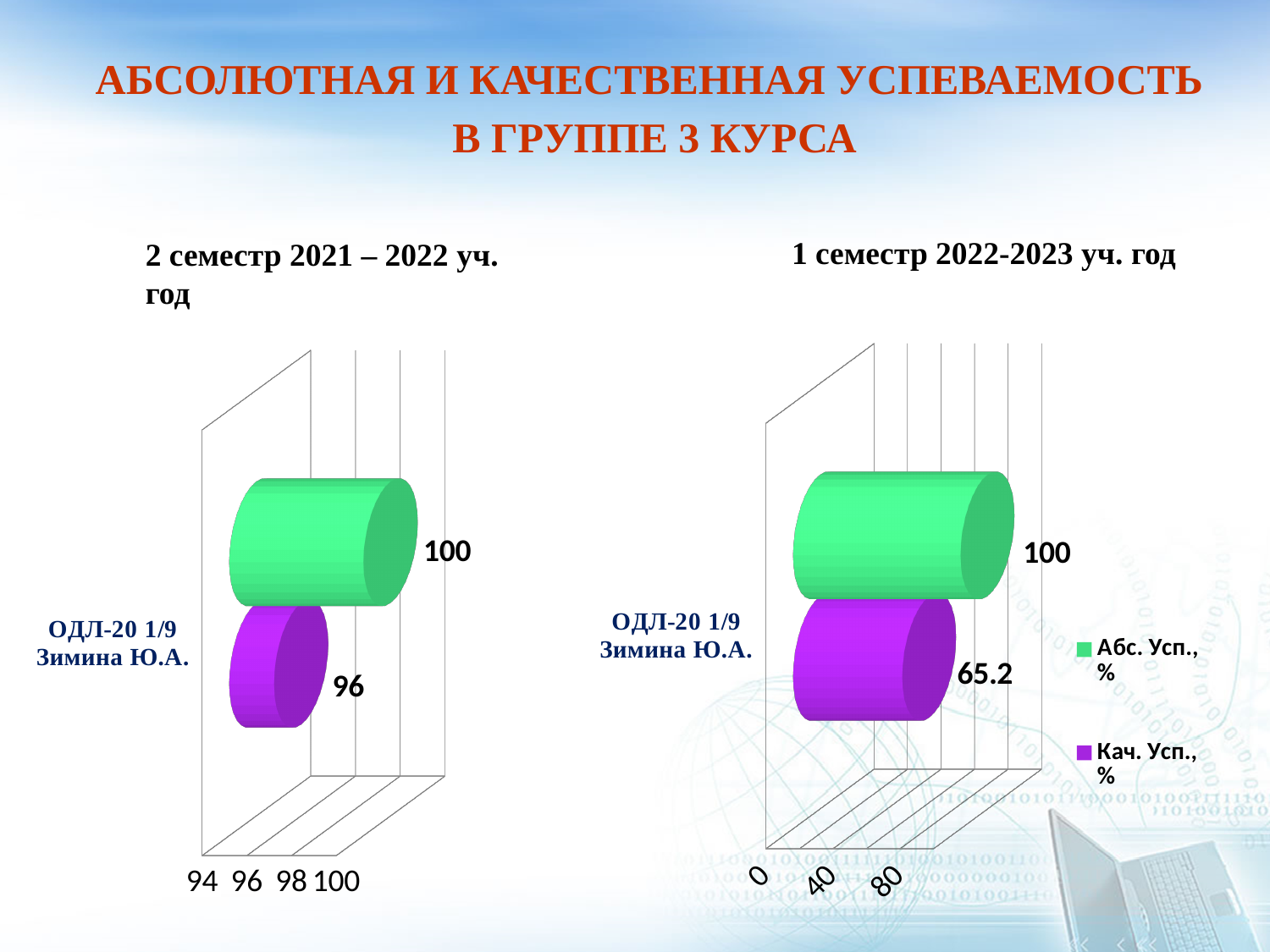
In the right-hand chart, which colour represents Кач. Усп., %? Purple In the chart for 1 семестр 2022-2023 уч. год, which series has the larger value, Абс. Усп., % or Кач. Усп., %? Абс. Усп., % In the chart for 1 семестр 2022-2023 уч. год, what is the difference between Абс. Усп., % and Кач. Усп., %? 34.8 What kind of chart is shown for 1 семестр 2022-2023 уч. год? Bar chart In the chart for 2 семестр 2021 – 2022 уч. год, which series has the lower value? Кач. Усп., % In the chart for 2 семестр 2021 – 2022 уч. год, what is the difference between Абс. Усп., % and Кач. Усп., %? 4 How many series does the legend on the right-hand chart list? 2 In the chart for 2 семестр 2021 – 2022 уч. год, what is the value of Абс. Усп., % for ОДЛ-20 1/9 Зимина Ю.А.? 100 In the chart for 1 семестр 2022-2023 уч. год, what is the value of Абс. Усп., %? 100 In the chart for 1 семестр 2022-2023 уч. год, what is the value of Кач. Усп., %? 65.2 How many categories are plotted in the chart for 2 семестр 2021 – 2022 уч. год? 1 In the chart for 2 семестр 2021 – 2022 уч. год, what is the value of Кач. Усп., % for ОДЛ-20 1/9 Зимина Ю.А.? 96